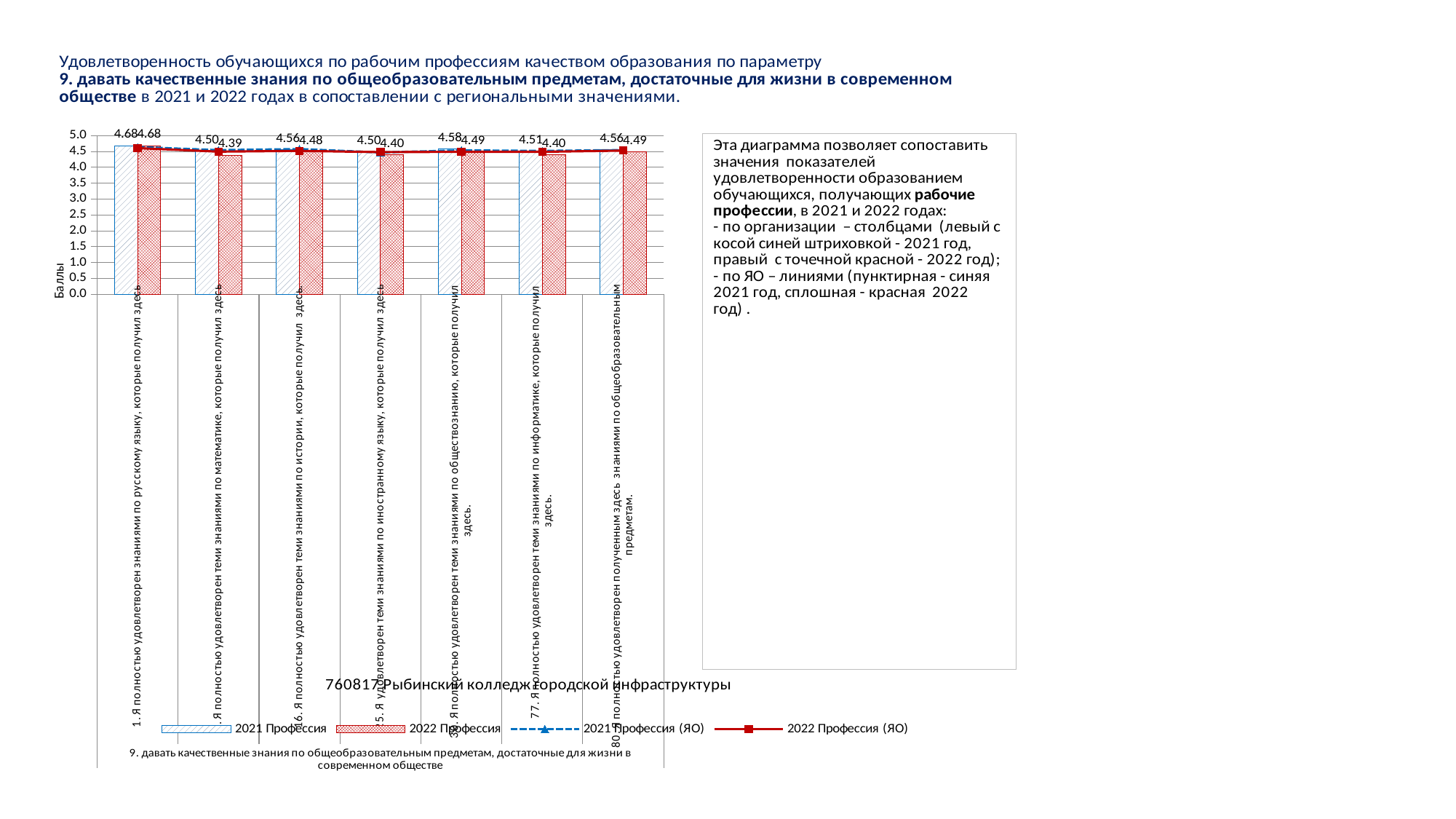
What is the 2022 Профессия value for the category about knowledge of mathematics (математике)? 4.39 What is the 2021 Профессия value for the category about knowledge of informatics (информатике)? 4.51 How many series does the chart legend list? 4 What is the 2021 Профессия value for the category about knowledge of Russian language (русскому языку)? 4.68 What is the title of the vertical axis of the chart? Баллы Which category has the lowest 2022 Профессия value? 6. Я полностью удовлетворен теми знаниями по математике, которые получил здесь How many categories are shown on the x axis of the chart? 7 What is the difference between the 2021 and 2022 Профессия values for the category about foreign language (иностранному языку)? 0.10 Is the 2022 Профессия value for mathematics (математике) greater or less than 4.0? greater Which category has the highest 2022 Профессия value? 1. Я полностью удовлетворен знаниями по русскому языку, которые получил здесь What is the 2022 Профессия value for the category about knowledge of social studies (обществознанию)? 4.49 Which is larger: the 2021 Профессия value for history (истории) or for social studies (обществознанию)? обществознанию (4.58)